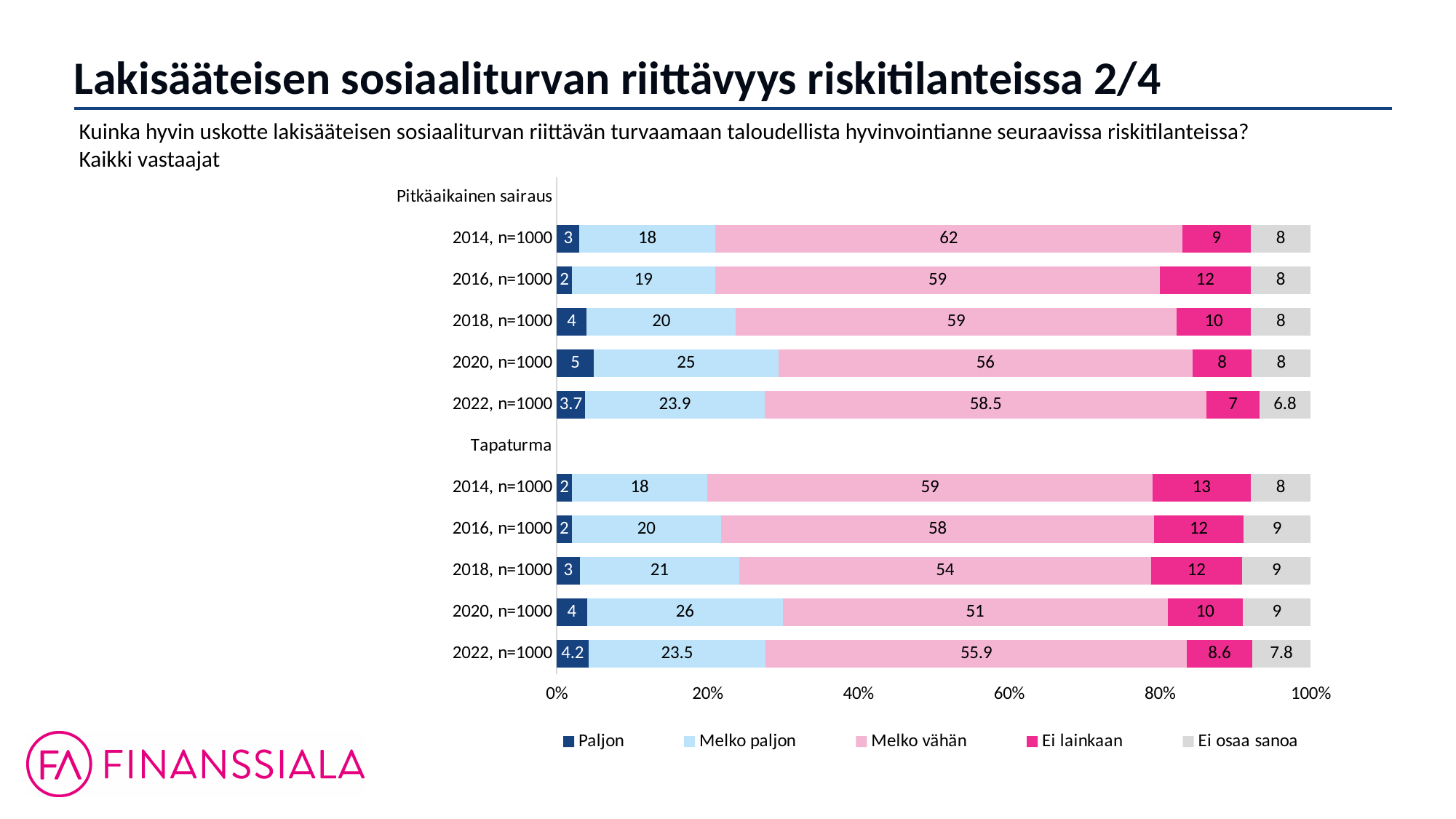
What is the value of Melko vähän for Pitkäaikainen sairaus in 2014, n=1000? 62 What is the value of Ei lainkaan for Tapaturma in 2014, n=1000? 13 What is the value of Paljon for Tapaturma in 2022, n=1000? 4.2 What kind of chart is shown on the slide? Stacked bar chart Within the Pitkäaikainen sairaus group, which year has the highest Melko vähän value? 2014, n=1000 How many bars are plotted in the chart? 10 What is the total of the Tapaturma 2022, n=1000 bar? 100 What is the value of Ei osaa sanoa for Pitkäaikainen sairaus in 2022, n=1000? 6.8 How many series does the legend list? 5 What is the difference between the Melko paljon values for Pitkäaikainen sairaus in 2020 and 2014? 7 Which has the larger Melko vähän value in 2018: Pitkäaikainen sairaus or Tapaturma? Pitkäaikainen sairaus Within the Tapaturma group, which year has the lowest Melko vähän value? 2020, n=1000